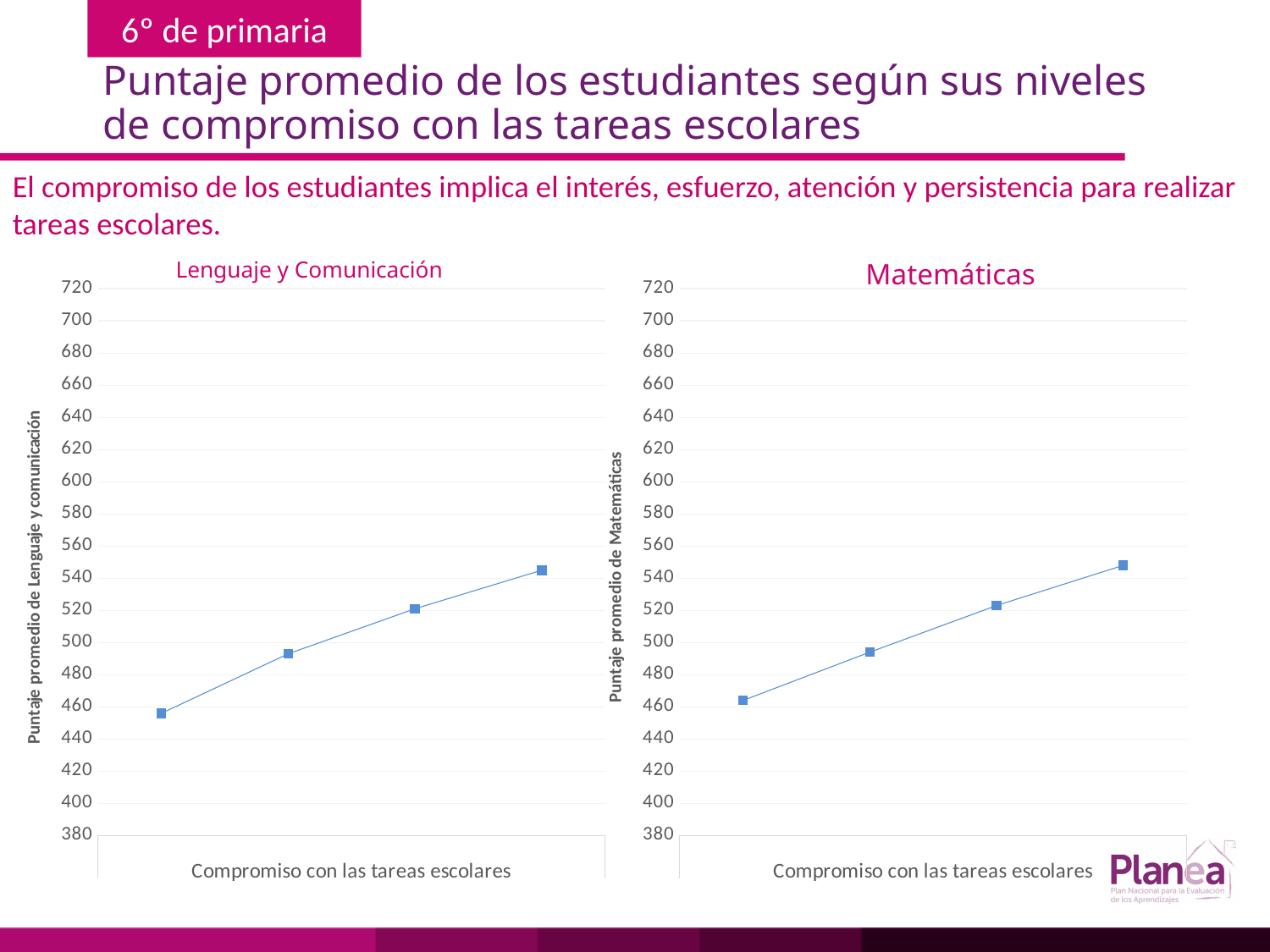
What is the x-axis label on the Matemáticas chart? Compromiso con las tareas escolares What kind of chart is the Lenguaje y Comunicación chart? line chart On the Lenguaje y Comunicación chart, is the value of the first (leftmost) point greater or less than 480? less How many data points are plotted on the Lenguaje y Comunicación chart? 4 On the Lenguaje y Comunicación chart, is the value of the last (rightmost) point greater or less than 520? greater How many data points are plotted on the Matemáticas chart? 4 What is the y-axis label on the Lenguaje y Comunicación chart? Puntaje promedio de Lenguaje y comunicación On the Matemáticas chart, do the values rise or fall from left to right along the x axis? rise On the Matemáticas chart, is the value of the first (leftmost) point greater or less than 480? less On the Lenguaje y Comunicación chart, do the values rise or fall from left to right along the x axis? rise What kind of chart is the Matemáticas chart? line chart